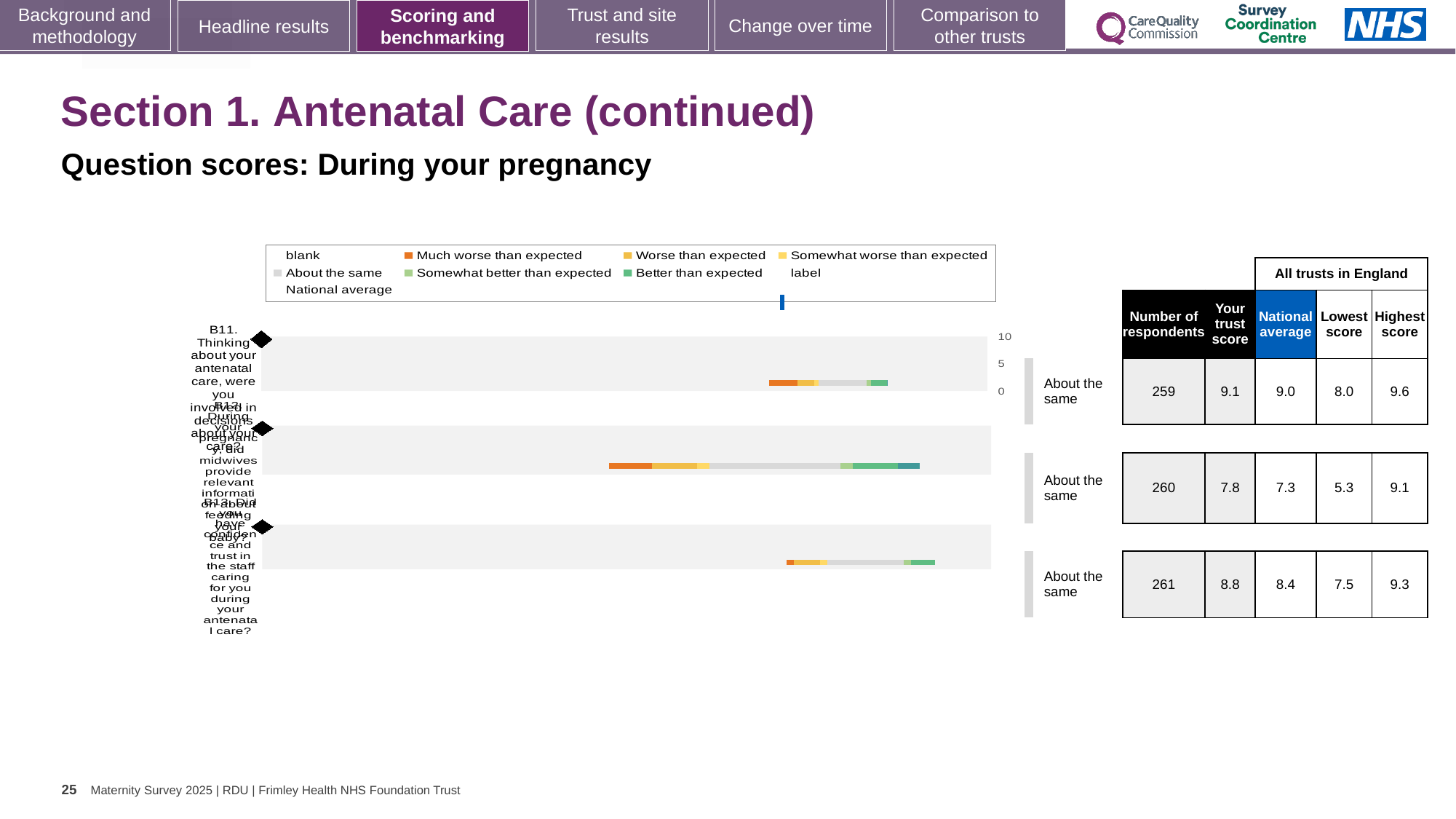
What kind of chart is shown on the slide? bar chart How many question rows (bars) are plotted in the chart? 3 Which row has the highest 'Your trust score'? B11 (first row), 9.1 Which row has the lowest 'Lowest score' among all trusts in England? second row, 5.3 What is the highest score across all trusts in England for the first row (B11)? 9.6 What colour does the legend use for 'Much worse than expected'? orange What is the national average for the second row of the chart? 7.3 For the third row, which is larger: the trust score or the national average? the trust score (8.8) What benchmark category is shown for all three rows? About the same What is the 'Your trust score' for the first row (B11, involved in decisions about your care)? 9.1 How many respondents are listed for the third row of the chart? 261 For the second row, what is the difference between the trust score and the national average? 0.5